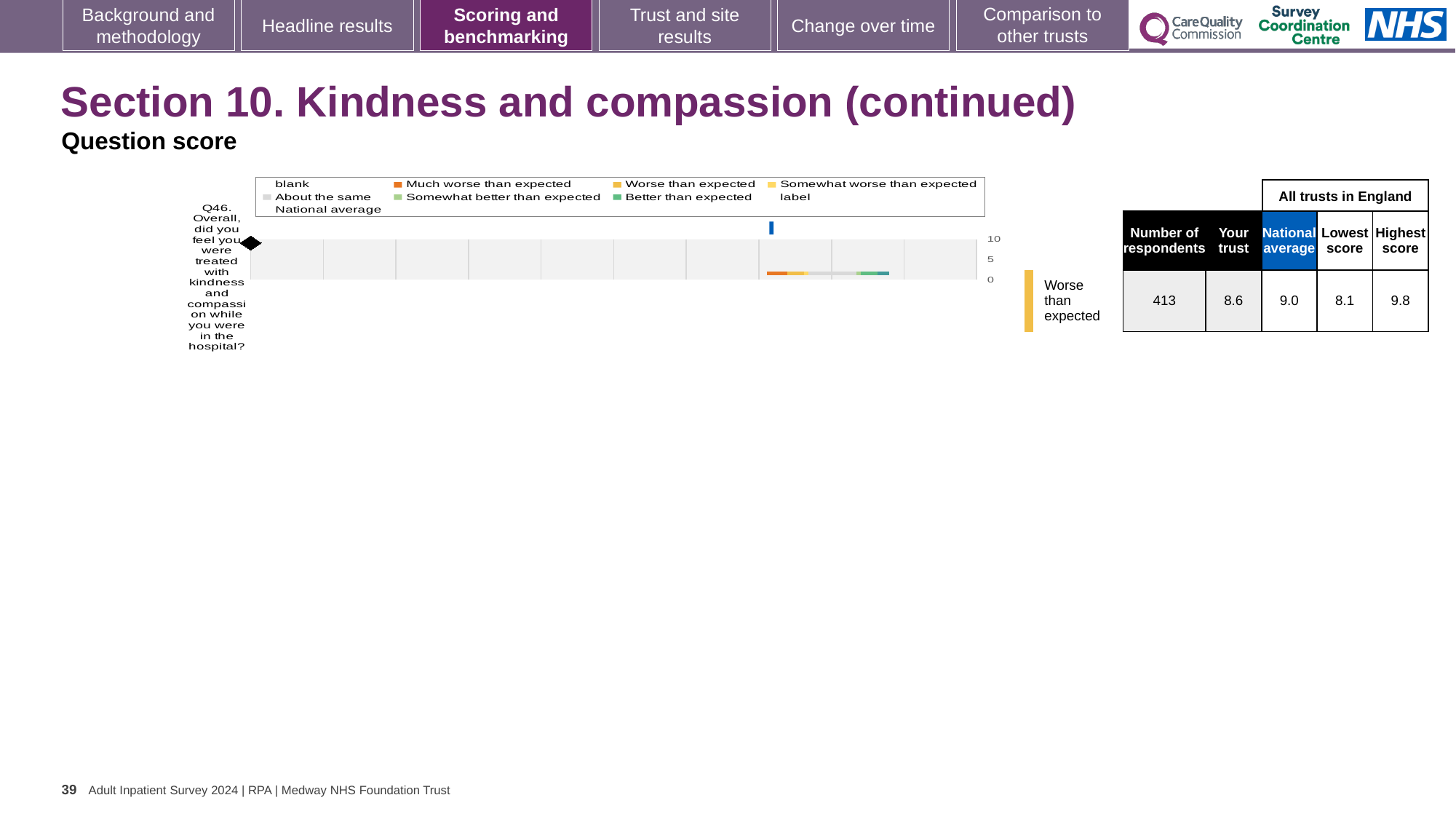
In the table beside the chart, what is the lowest score among all trusts in England for Q46? 8.1 What rating label is shown to the right of the chart for Q46? Worse than expected In the table beside the chart, what is the number of respondents for Q46? 413 In the table beside the chart, what is the highest score among all trusts in England for Q46? 9.8 In the table beside the chart, which is larger for Q46: the 'Your trust' score or the national average? National average In the table beside the chart, what is the difference between the highest score and the lowest score for Q46? 1.7 What kind of chart is shown on the slide for Q46? bar chart Which question is plotted in the chart? Q46. Overall, did you feel you were treated with kindness and compassion while you were in the hospital? How many entries does the chart's legend list? 9 In the table beside the chart, what is the 'Your trust' score for Q46? 8.6 In the table beside the chart, what is the national average score for Q46? 9.0 How many questions (categories) are plotted in the chart? 1